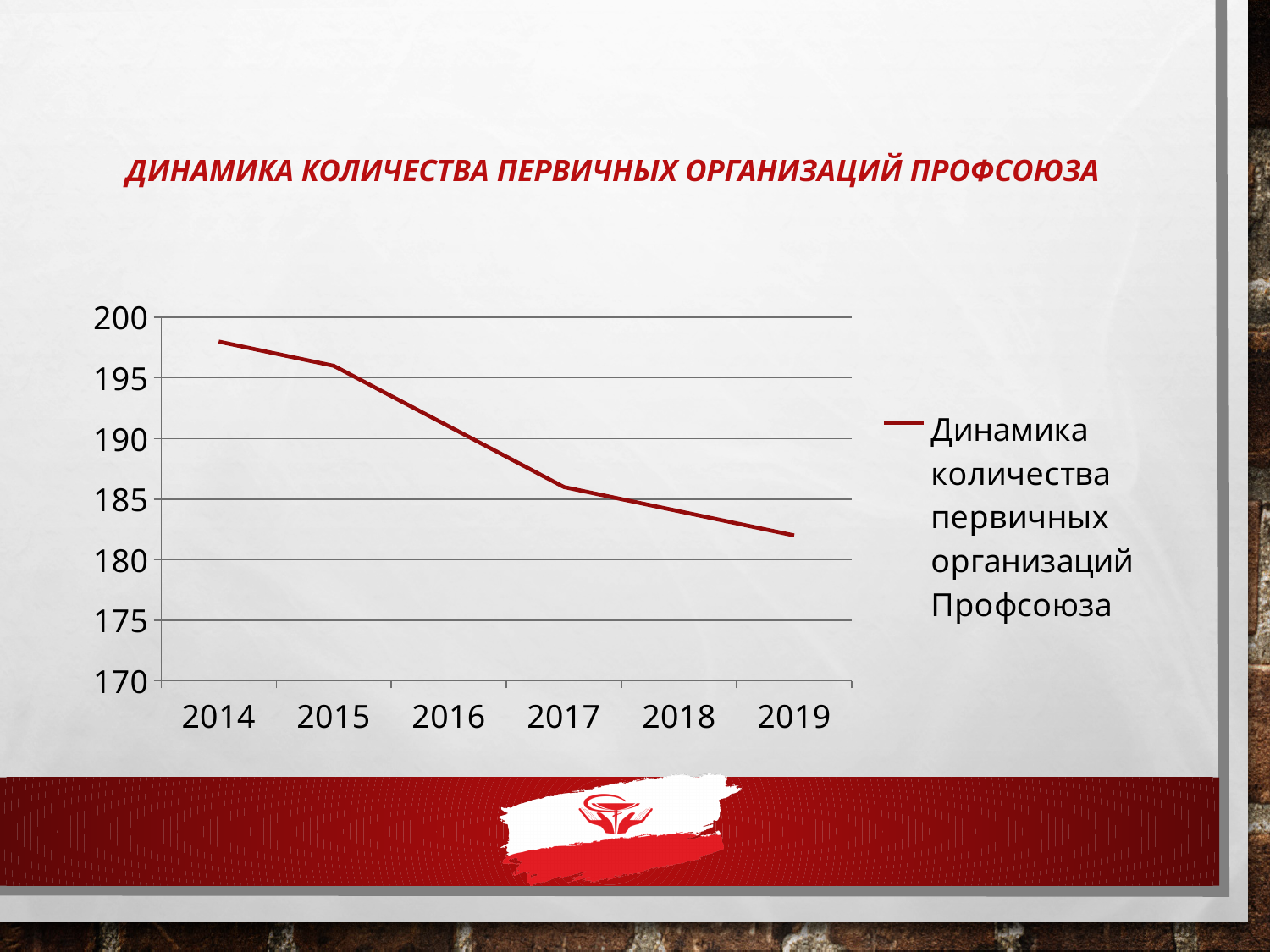
Is the value for 2019 greater or less than 185? less How many series does the legend list? 1 Which year has the lowest value? 2019 What type of chart is shown on the slide? line chart Which year has the highest value? 2014 What is the title of the chart on the slide? ДИНАМИКА КОЛИЧЕСТВА ПЕРВИЧНЫХ ОРГАНИЗАЦИЙ ПРОФСОЮЗА How many years are plotted on the x axis? 6 Is the value for 2015 greater or less than 190? greater Do the values rise or fall from 2014 to 2019? fall Is the value for 2017 greater or less than 190? less Which is larger, the value for 2016 or the value for 2018? 2016